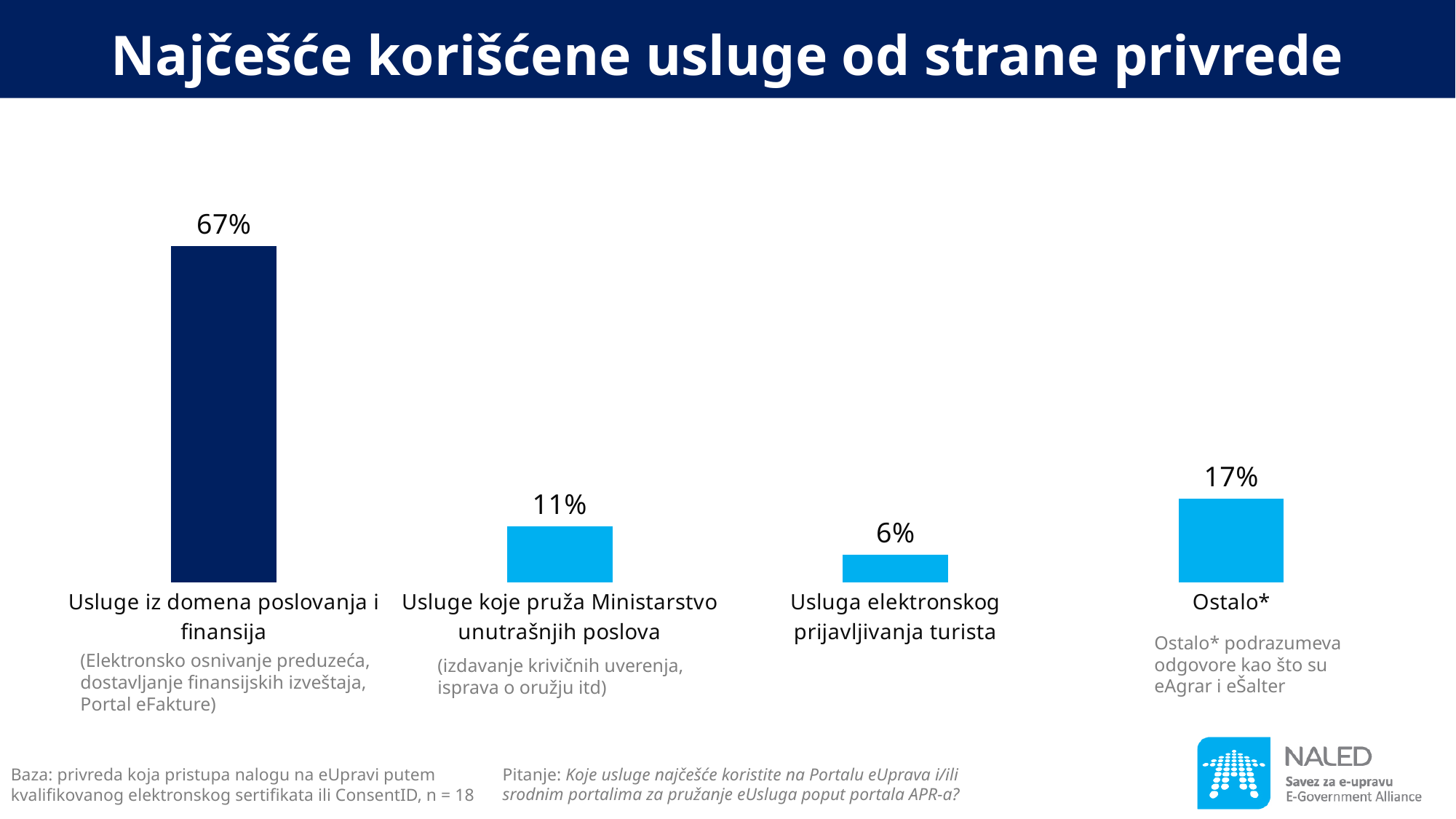
What is the difference between the values for 'Ostalo*' and 'Usluge koje pruža Ministarstvo unutrašnjih poslova'? 6% What is the value for 'Ostalo*'? 17% What is the title of the slide? Najčešće korišćene usluge od strane privrede Which is larger: the value for 'Ostalo*' or the value for 'Usluge koje pruža Ministarstvo unutrašnjih poslova'? Ostalo* What is the difference between the values for 'Usluge iz domena poslovanja i finansija' and 'Ostalo*'? 50% Which category has the highest value? Usluge iz domena poslovanja i finansija What kind of chart is shown on the slide? Bar chart What is the value for 'Usluge iz domena poslovanja i finansija'? 67% What is the value for 'Usluge koje pruža Ministarstvo unutrašnjih poslova'? 11% How many categories are shown in the chart? 4 Which category has the lowest value? Usluga elektronskog prijavljivanja turista What is the value for 'Usluga elektronskog prijavljivanja turista'? 6%